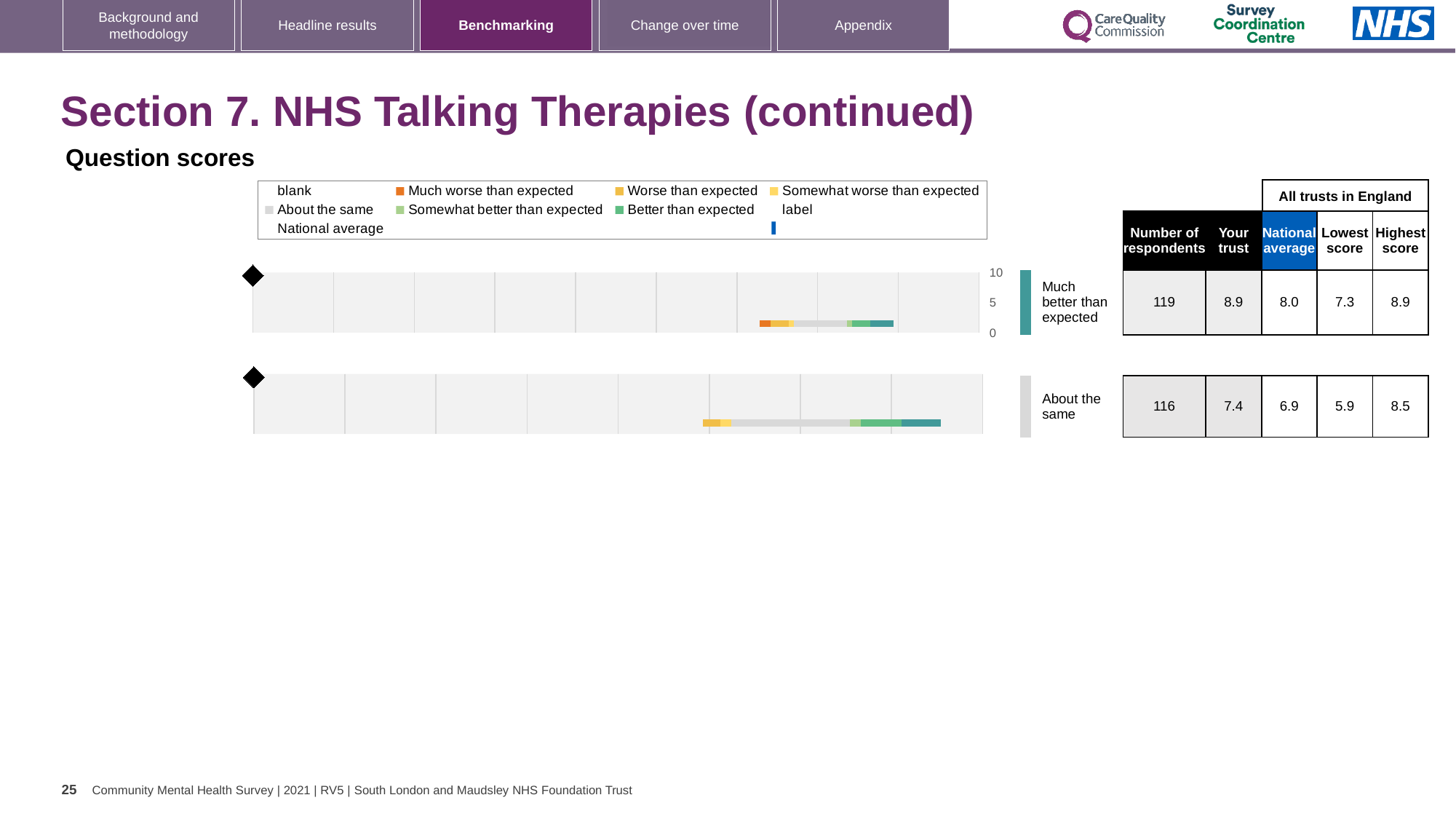
For the second chart (About the same), what is the National average shown in the table? 6.9 Which of the two charts has the higher 'Your trust' score: Much better than expected or About the same? Much better than expected How many question score charts are shown on the slide? 2 For the second chart (About the same), how many respondents are listed? 116 What is the highest value shown on the chart axis? 10 For the first chart (Much better than expected), what is the 'Your trust' score shown in the table? 8.9 For the second chart (About the same), what is the Lowest score among all trusts in England? 5.9 For the first chart (Much better than expected), what is the Highest score among all trusts in England? 8.9 What kind of chart is used to show the question scores on this slide? bar chart What colour does the legend use for 'Much worse than expected'? orange For the first chart (Much better than expected), how many respondents are listed? 119 For the first chart (Much better than expected), what is the difference between the 'Your trust' score and the National average? 0.9